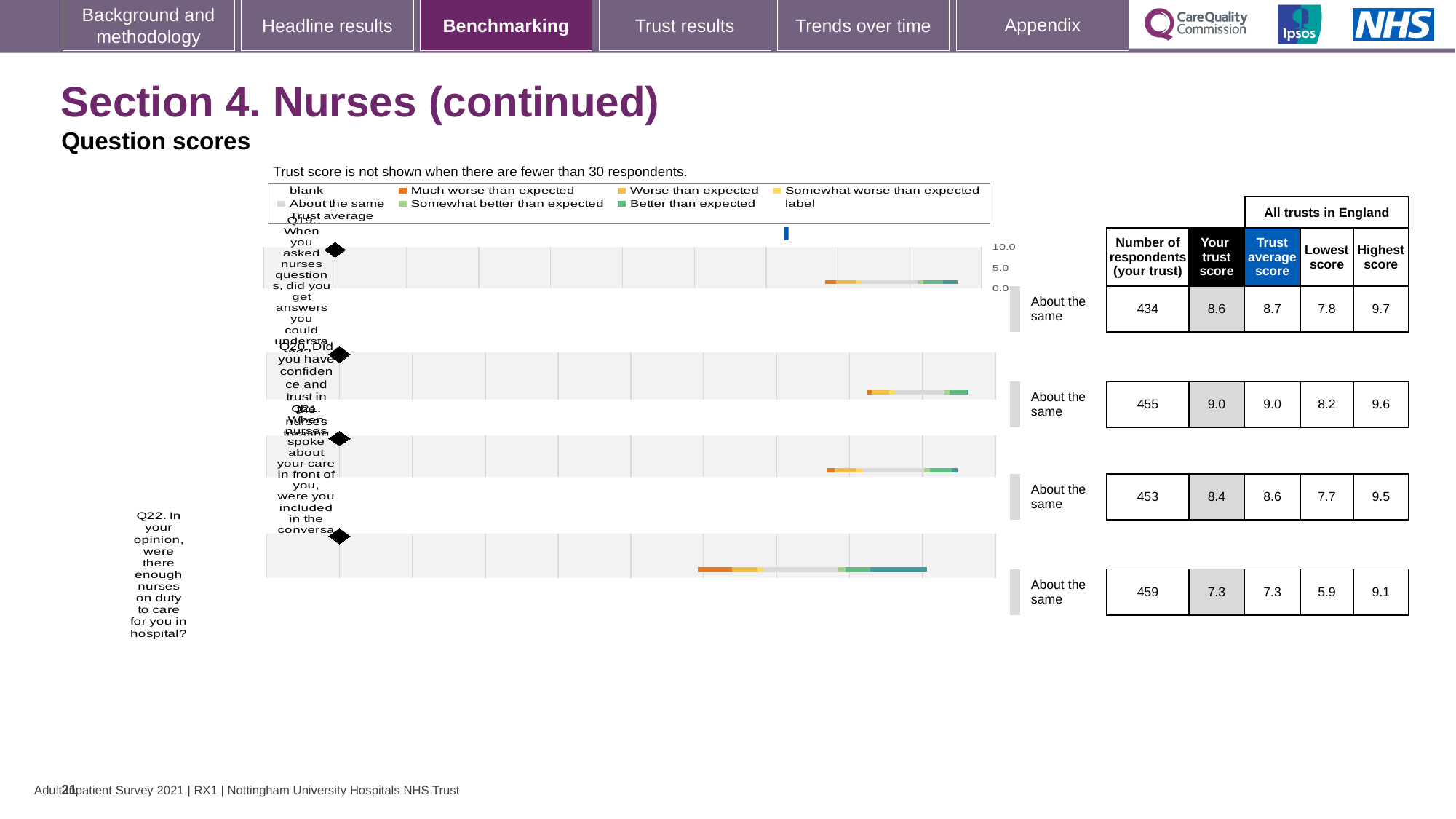
What is the 'Your trust score' for Q19 (When you asked nurses questions, did you get answers you could understand)? 8.6 What is the difference between the highest score and the lowest score for Q22? 3.2 Which question has the highest 'Your trust score'? Q20 How many questions (categories) are plotted in the chart? 4 What kind of chart is used to show the question scores on this slide? bar chart How many respondents from your trust answered Q22 (were there enough nurses on duty)? 459 What is the lowest score across all trusts in England for Q20 (Did you have confidence and trust in the nurses)? 8.2 What is the trust average score for Q21 (When nurses spoke about your care in front of you, were you included in the conversation)? 8.6 Is the trust score for Q22 greater or less than 5.0 on the axis? greater For Q19, which is larger: your trust score or the trust average score? Trust average score What benchmark category is shown next to each of the four questions? About the same Which question has the lowest 'Your trust score'? Q22